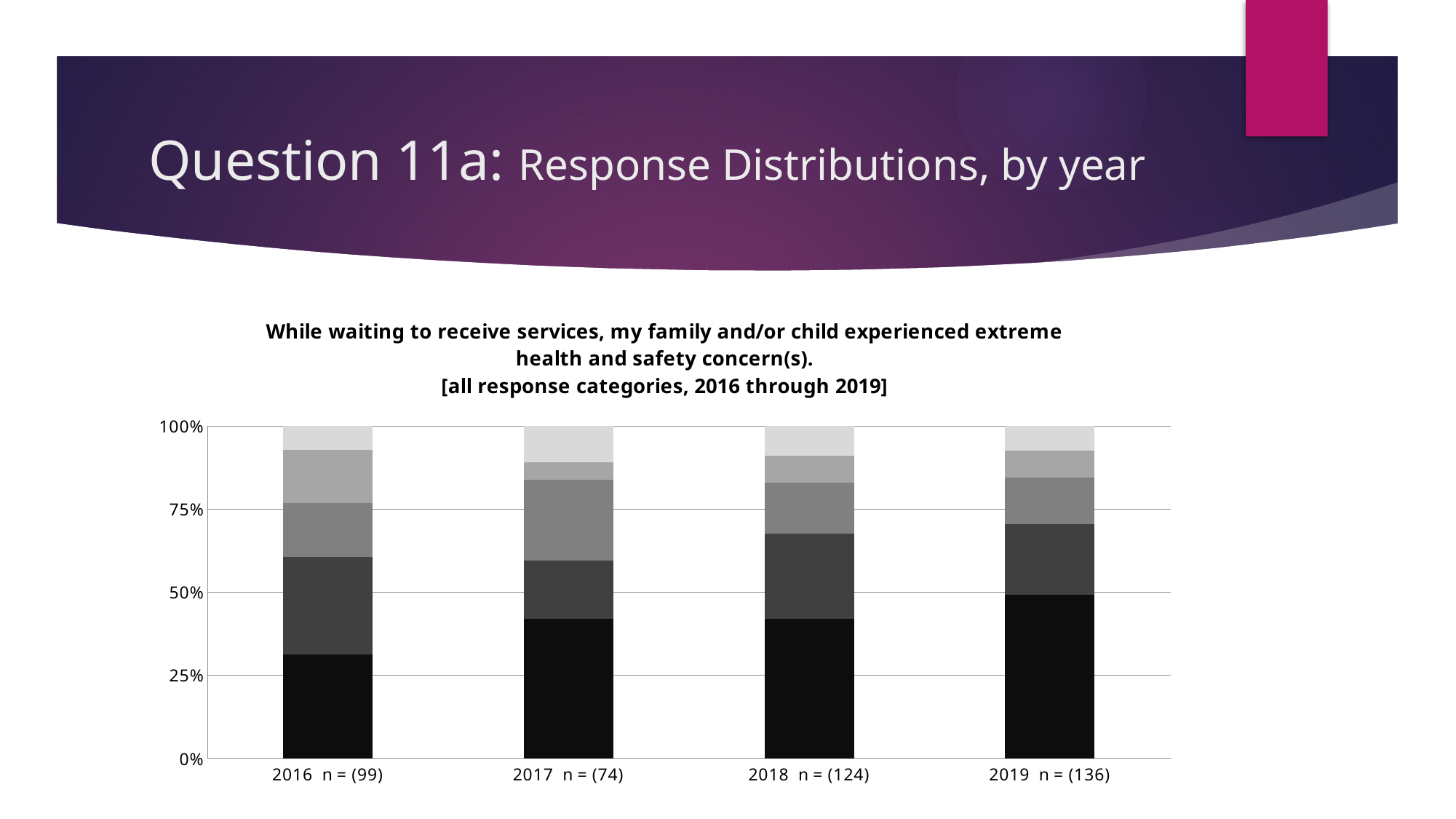
How many years (bars) are shown in the chart? 4 Which year has the larger bottom (black) segment, 2016 or 2019? 2019 Is the bottom (black) segment of the 2016 bar greater or less than 50%? less What kind of chart is shown on the slide? stacked bar chart What is the sample size (n) shown for 2017? 74 Is the bottom (black) segment of the 2016 bar greater or less than 25%? greater What is the difference between the sample size for 2019 and the sample size for 2016? 37 Which year has the smallest sample size (n)? 2017 Which year has the smallest bottom (black) segment? 2016 What is the highest value shown on the vertical axis? 100% What is the sample size (n) shown for 2018? 124 Which year has the largest sample size (n)? 2019